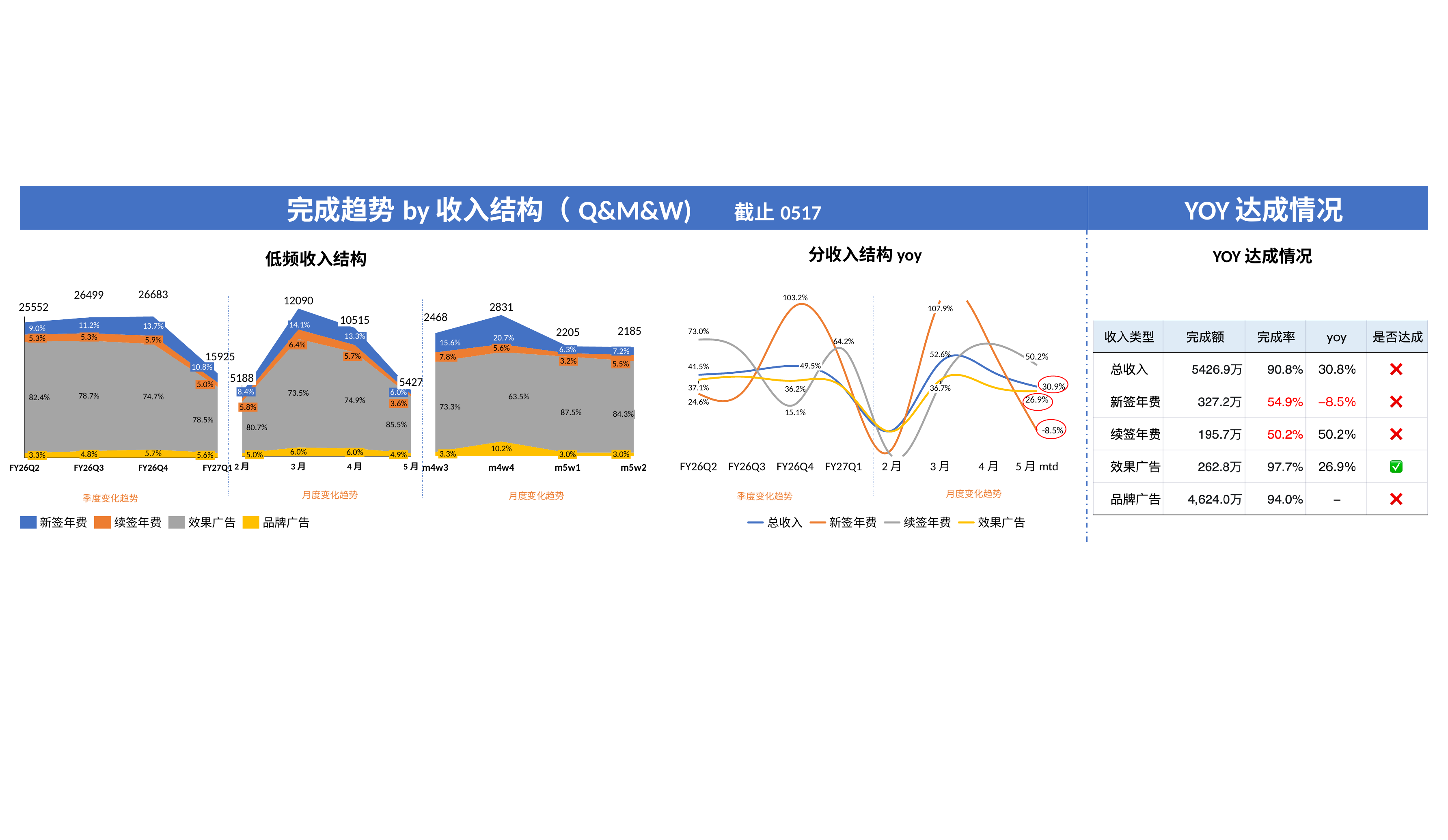
In the 低频收入结构 chart, which quarter has the highest total value in the quarterly panel? FY26Q4 In the 低频收入结构 chart, what is the difference between the total for 3月 and the total for 4月? 1575 In the 低频收入结构 chart, what is the total value labeled for FY26Q4 in the quarterly panel? 26683 In the 低频收入结构 chart, what share does 新签年费 have in week m4w4? 20.7% In the 分收入结构 yoy chart, what is the yoy value for 总收入 at 5月 mtd? 30.9% In the 低频收入结构 chart, which month has the lowest total value in the monthly panel? 2月 In the 分收入结构 yoy chart, which series has the lowest value at 5月 mtd? 新签年费 In the 低频收入结构 chart, what share does 效果广告 have in FY26Q2? 82.4% In the 分收入结构 yoy chart, what is the yoy value for 新签年费 in FY26Q4? 103.2% How many series does the legend of the 低频收入结构 chart list? 4 What kind of chart is the 分收入结构 yoy chart? line chart In the 低频收入结构 chart, is the total for m4w4 larger or smaller than the total for m5w1? larger